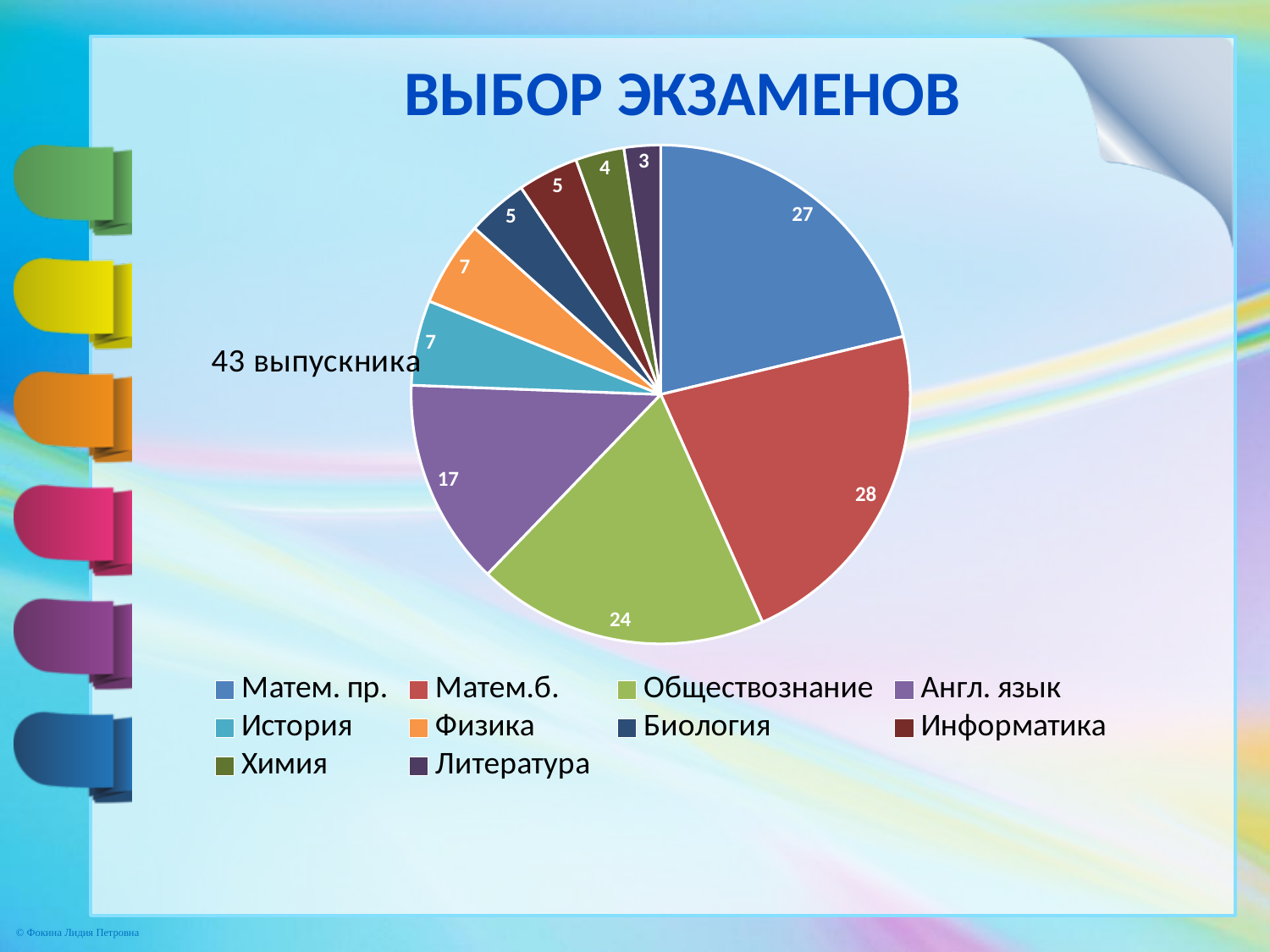
What is the value for Литература? 3 Which category has the smallest slice? Литература Which is larger, the value for Обществознание or the value for Англ. язык? Обществознание What kind of chart is shown on the slide? pie chart What is the difference between the values for Матем.б. and Матем. пр.? 1 Which category has the largest slice? Матем.б. What is the value for Обществознание? 24 What is the title of the chart? 43 выпускника How many slices does the pie chart have? 10 What is the difference between the values for История and Химия? 3 What is the value for Англ. язык? 17 What is the value for Матем.б.? 28